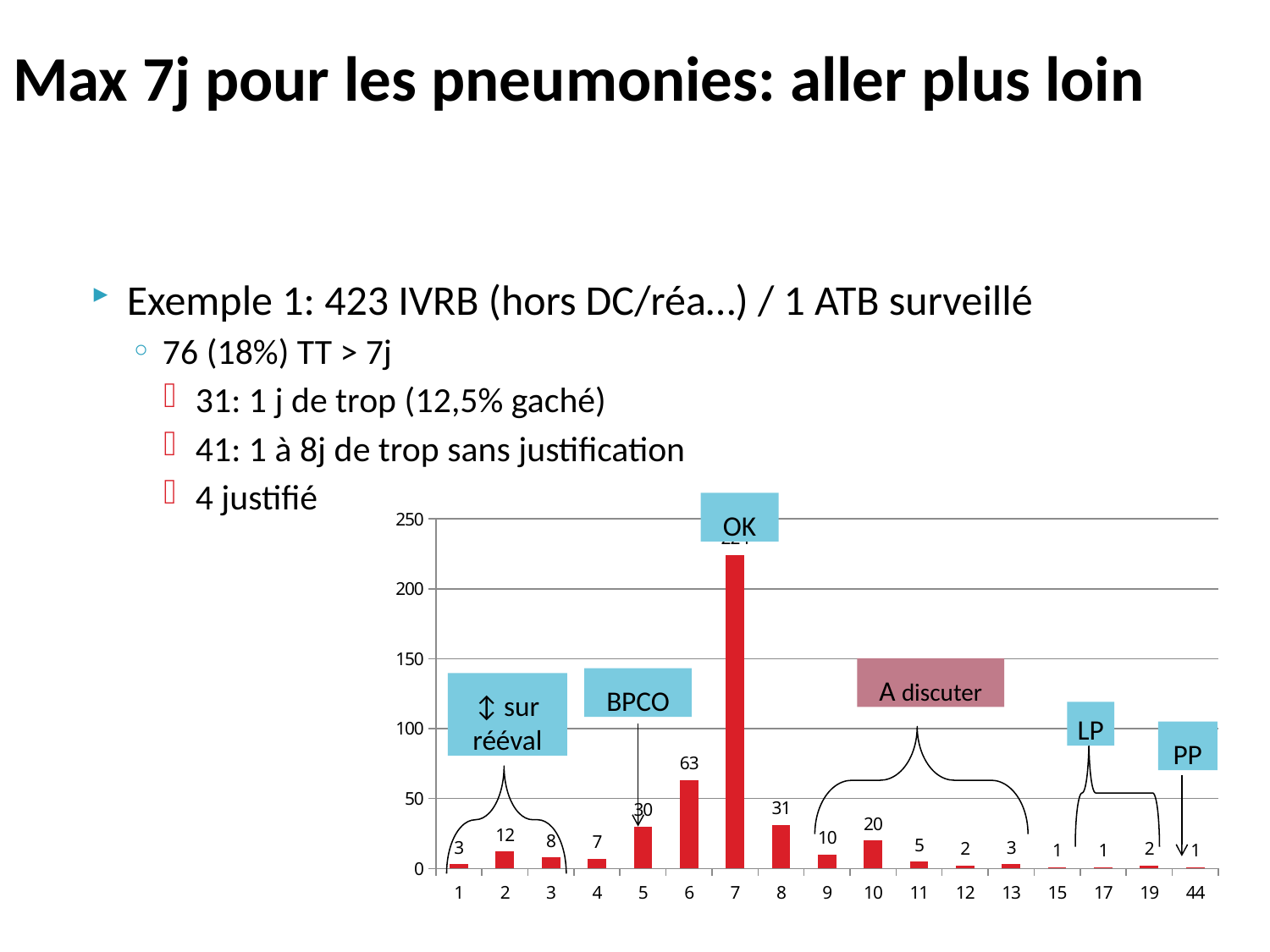
What is the value for category 2? 12 How many categories are shown on the x axis? 17 Is the value for category 7 greater or less than 200? greater What is the value for category 8? 31 What is the difference between the values for category 10 and category 11? 15 What is the difference between the values for category 6 and category 5? 33 Which is larger, the value for category 8 or the value for category 9? category 8 What is the value for category 6? 63 What label is in the box above the tallest bar? OK What is the value for category 10? 20 Which category has the highest bar? 7 What kind of chart is shown on the slide? bar chart